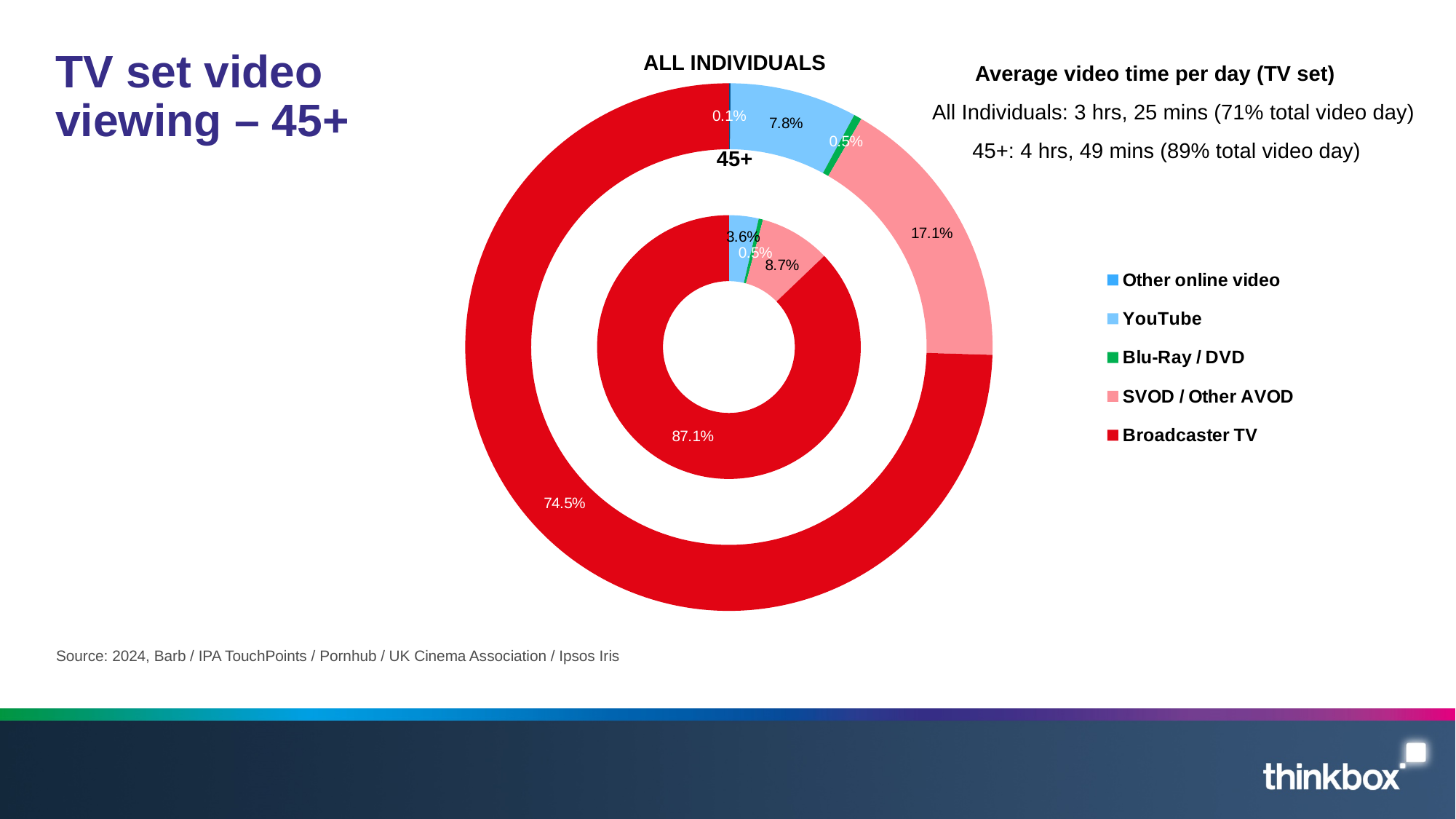
What is the difference between the Broadcaster TV share for 45+ and for All Individuals? 12.6 percentage points What is the YouTube share in the 45+ ring? 3.6% Which category has the largest share in the 45+ ring? Broadcaster TV What kind of chart is shown on the slide? Doughnut chart How many categories does the legend list? 5 What share of TV set video viewing for the 45+ ring is Broadcaster TV? 87.1% What is the YouTube share in the All Individuals ring? 7.8% What share of TV set video viewing for All Individuals is Broadcaster TV? 74.5% Which is larger: the SVOD / Other AVOD share for All Individuals or for 45+? All Individuals Which labelled category has the smallest share in the All Individuals ring? Other online video What is the SVOD / Other AVOD share in the 45+ ring? 8.7% What is the SVOD / Other AVOD share in the All Individuals ring? 17.1%